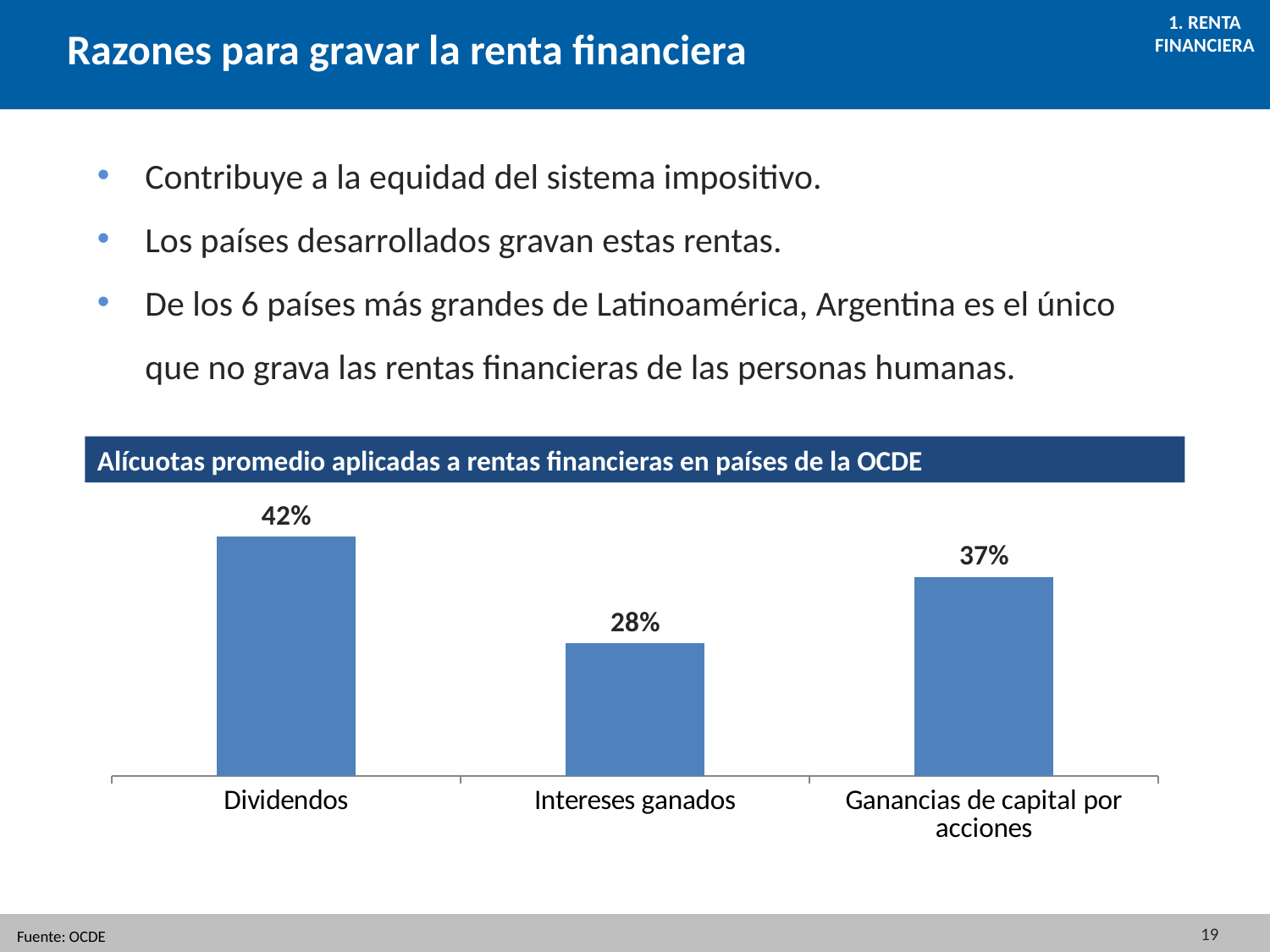
What is the difference between the rate for Dividendos and the rate for Ganancias de capital por acciones? 5% Which category has the lowest average rate? Intereses ganados What kind of chart is shown on the slide? Bar chart What is the difference between the rate for Dividendos and the rate for Intereses ganados? 14% Which category has the highest average rate? Dividendos How many categories are shown in the chart? 3 What is the title of the chart? Alícuotas promedio aplicadas a rentas financieras en países de la OCDE What is the average rate applied to Intereses ganados? 28% Which is larger, the rate for Ganancias de capital por acciones or the rate for Intereses ganados? Ganancias de capital por acciones What is the source cited for the chart? OCDE What is the average rate applied to Dividendos? 42% What is the average rate applied to Ganancias de capital por acciones? 37%